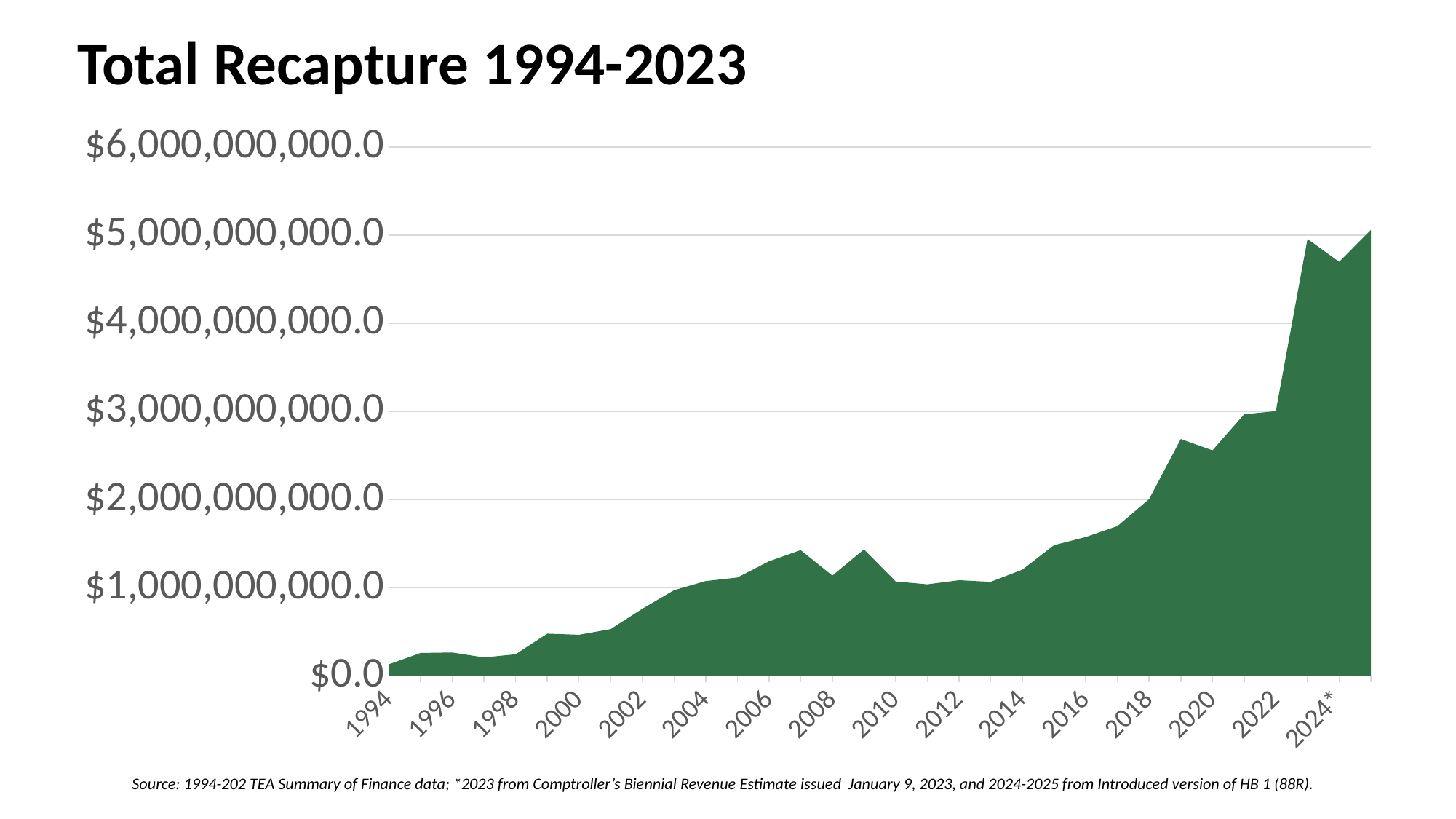
Is the value for 2024* greater or less than $4,000,000,000.0? greater Is the value for 2020 greater or less than $2,000,000,000.0? greater Is the value for 2000 greater or less than $1,000,000,000.0? less How many year labels are shown on the x axis? 16 What kind of chart is shown on the slide? Area chart What is the title of the chart? Total Recapture 1994-2023 Which labeled year on the x axis has the lowest value? 1994 Overall, do the values rise or fall from 1994 to the right end of the chart? Rise Which labeled year on the x axis has the highest value? 2024* Which year has the larger value, 2016 or 2020? 2020